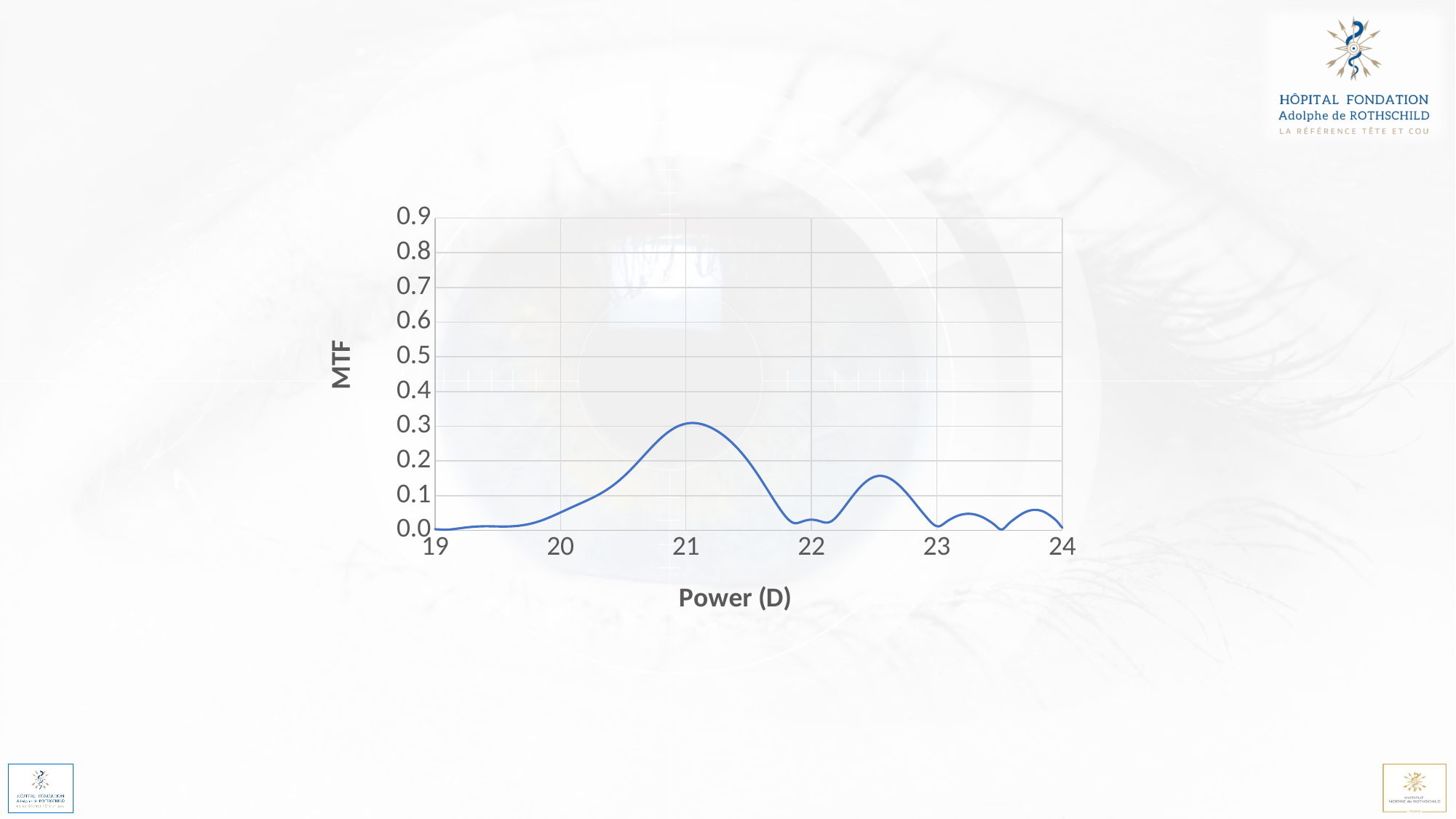
Is the MTF value at a power of 21 D greater or less than 0.2? greater Does the MTF curve rise or fall as power increases from 19 D to 21 D? rise What is the label of the vertical axis of the chart? MTF What is the label of the horizontal axis of the chart? Power (D) What kind of chart is shown on the slide? line chart Which has the higher MTF value: a power of 21 D or a power of 22 D? 21 D Is the MTF value at a power of 22 D greater or less than 0.1? less Is the MTF value at a power of 19 D greater or less than 0.1? less Does the MTF curve rise or fall as power increases from 21 D to 22 D? fall At which labelled x-axis value (Power) does the MTF curve reach its highest point? 21